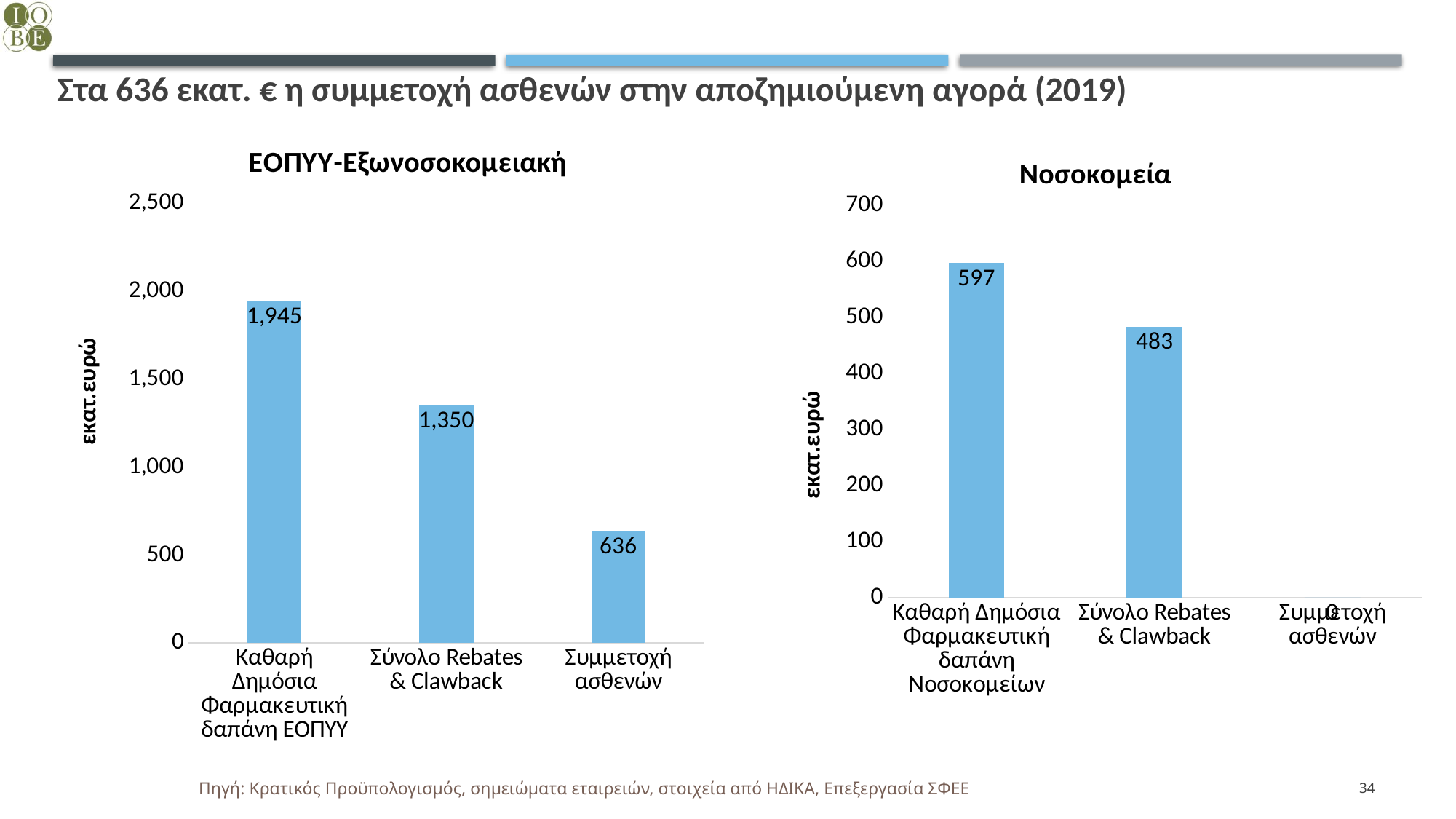
In the ΕΟΠΥΥ-Εξωνοσοκομειακή chart, which category has the highest value? Καθαρή Δημόσια Φαρμακευτική δαπάνη ΕΟΠΥΥ In the ΕΟΠΥΥ-Εξωνοσοκομειακή chart, what is the difference between Καθαρή Δημόσια Φαρμακευτική δαπάνη ΕΟΠΥΥ and Σύνολο Rebates & Clawback? 595 In the Νοσοκομεία chart, what is the value for Καθαρή Δημόσια Φαρμακευτική δαπάνη Νοσοκομείων? 597 In the Νοσοκομεία chart, what is the value for Σύνολο Rebates & Clawback? 483 In the ΕΟΠΥΥ-Εξωνοσοκομειακή chart, what is the value for Καθαρή Δημόσια Φαρμακευτική δαπάνη ΕΟΠΥΥ? 1,945 In the Νοσοκομεία chart, which category has the lowest value? Συμμετοχή ασθενών In the Νοσοκομεία chart, what is the difference between Καθαρή Δημόσια Φαρμακευτική δαπάνη Νοσοκομείων and Σύνολο Rebates & Clawback? 114 In the Νοσοκομεία chart, what is the value for Συμμετοχή ασθενών? 0 In the ΕΟΠΥΥ-Εξωνοσοκομειακή chart, what is the value for Σύνολο Rebates & Clawback? 1,350 What type of chart is the ΕΟΠΥΥ-Εξωνοσοκομειακή chart? Bar chart In the ΕΟΠΥΥ-Εξωνοσοκομειακή chart, what is the value for Συμμετοχή ασθενών? 636 How many categories are shown in the Νοσοκομεία chart? 3